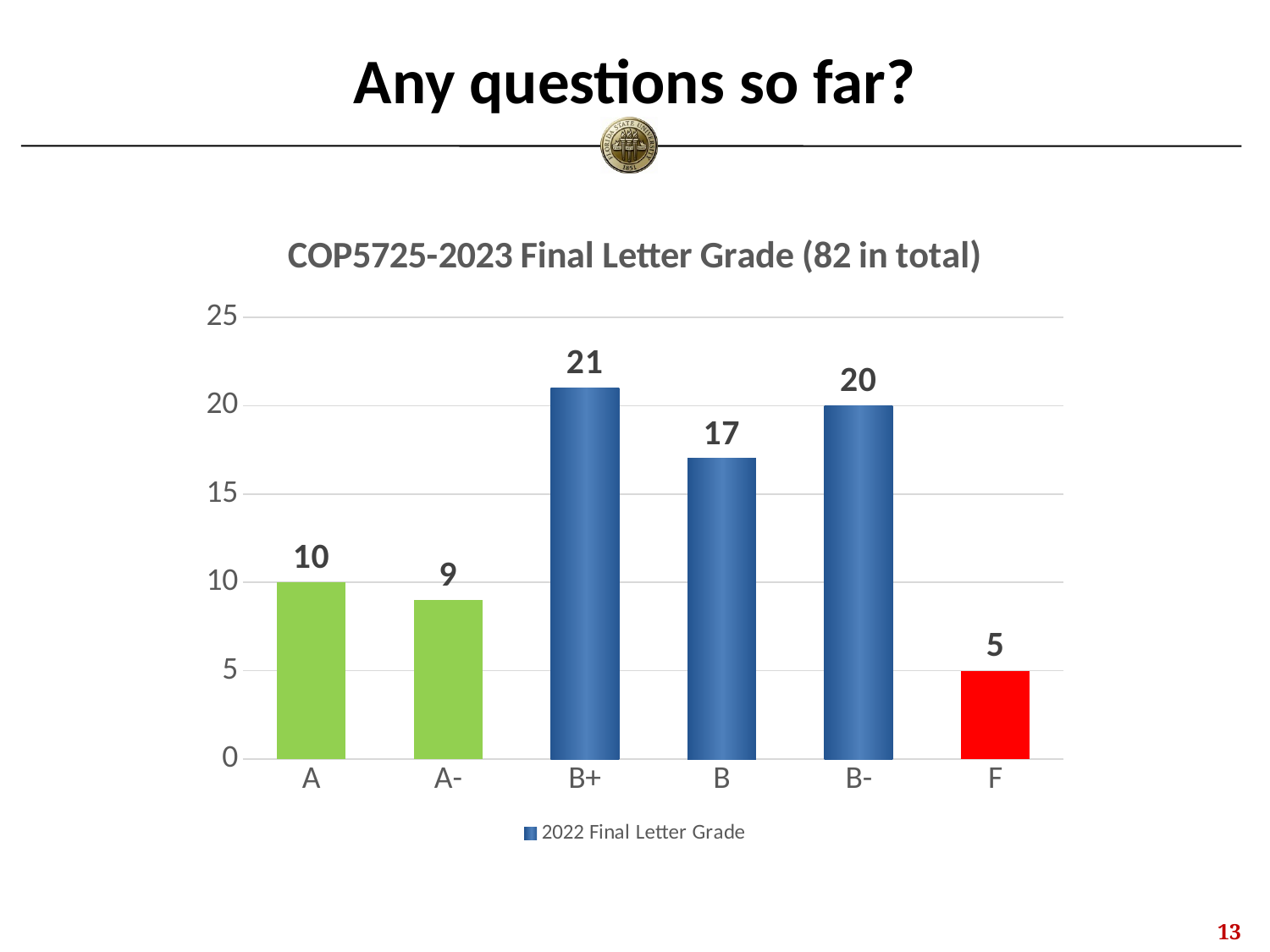
Which letter grade has the highest count? B+ Is the value for B- greater or less than 15? greater What is the value for the F grade? 5 How many series does the legend list? 1 Which has a larger count, A or A-? A Which letter grade has the lowest count? F What is the title of the chart? COP5725-2023 Final Letter Grade (82 in total) What is the value for the A- grade? 9 How many letter grade categories are shown on the x axis? 6 How many students received a B+? 21 What kind of chart is shown on the slide? bar chart What is the difference between the counts for B+ and B? 4